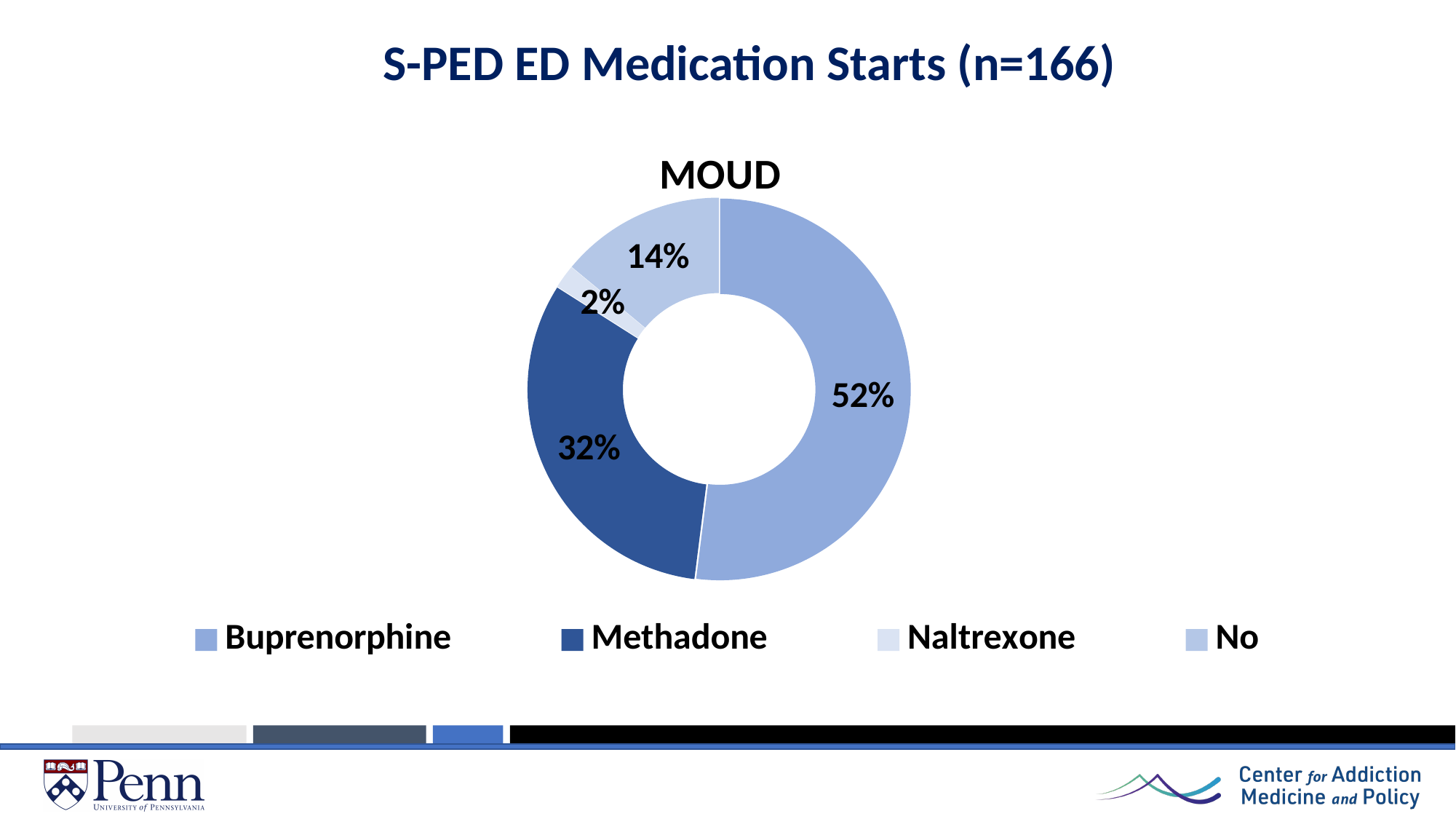
How many categories does the MOUD chart show? 4 What is the title of the slide? S-PED ED Medication Starts (n=166) What kind of chart is shown on the slide? Doughnut (pie) chart What percentage of the MOUD chart is Methadone? 32% Which is larger, the share for Methadone or the share for No? Methadone What is the difference in percentage points between Buprenorphine and Methadone? 20 Which category has the smallest share in the MOUD chart? Naltrexone What percentage of the MOUD chart is Buprenorphine? 52% What percentage of the MOUD chart is labelled No? 14% What is the combined share of Buprenorphine and Methadone? 84% Which category has the largest share in the MOUD chart? Buprenorphine What percentage of the MOUD chart is Naltrexone? 2%